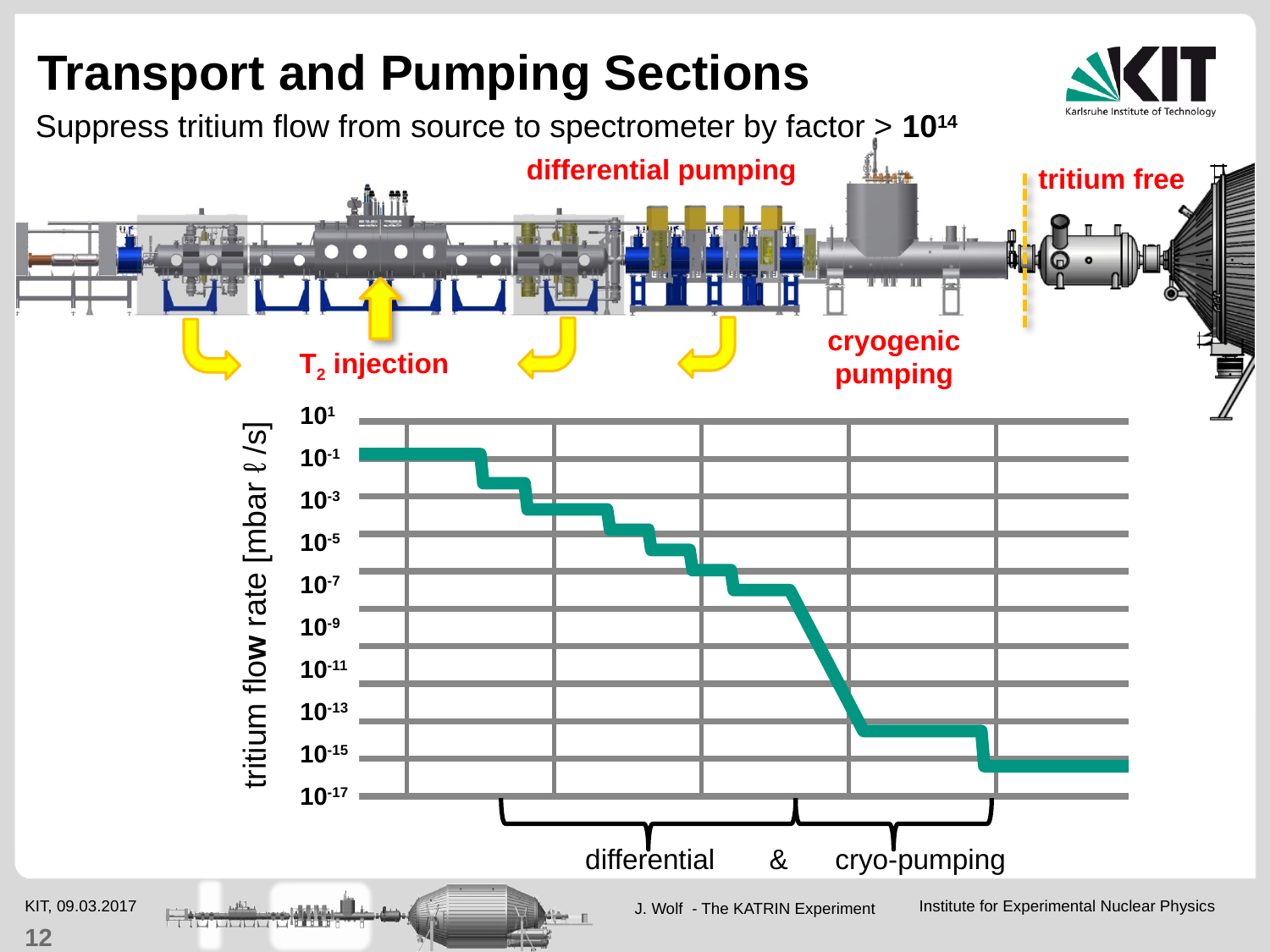
What is the label of the y axis of the chart? tritium flow rate [mbar ℓ/s] What is the tritium flow rate at the left end of the plotted line? 10^-1 What is the lowest tick value shown on the y axis? 10^-17 Is the tritium flow rate at the left end of the line greater or less than 10^-3? greater Which is larger, the tritium flow rate at the left end of the line or at the right end? left end What kind of chart is shown on the slide? line chart How many lines are plotted in the chart? 1 What is the highest tick value shown on the y axis? 10^1 Does the tritium flow rate rise or fall from left to right along the chart? fall Is the tritium flow rate at the right end of the line greater or less than 10^-13? less Is the tritium flow rate at the right end of the line greater or less than 10^-17? greater How many tick labels are shown on the y axis of the chart? 10